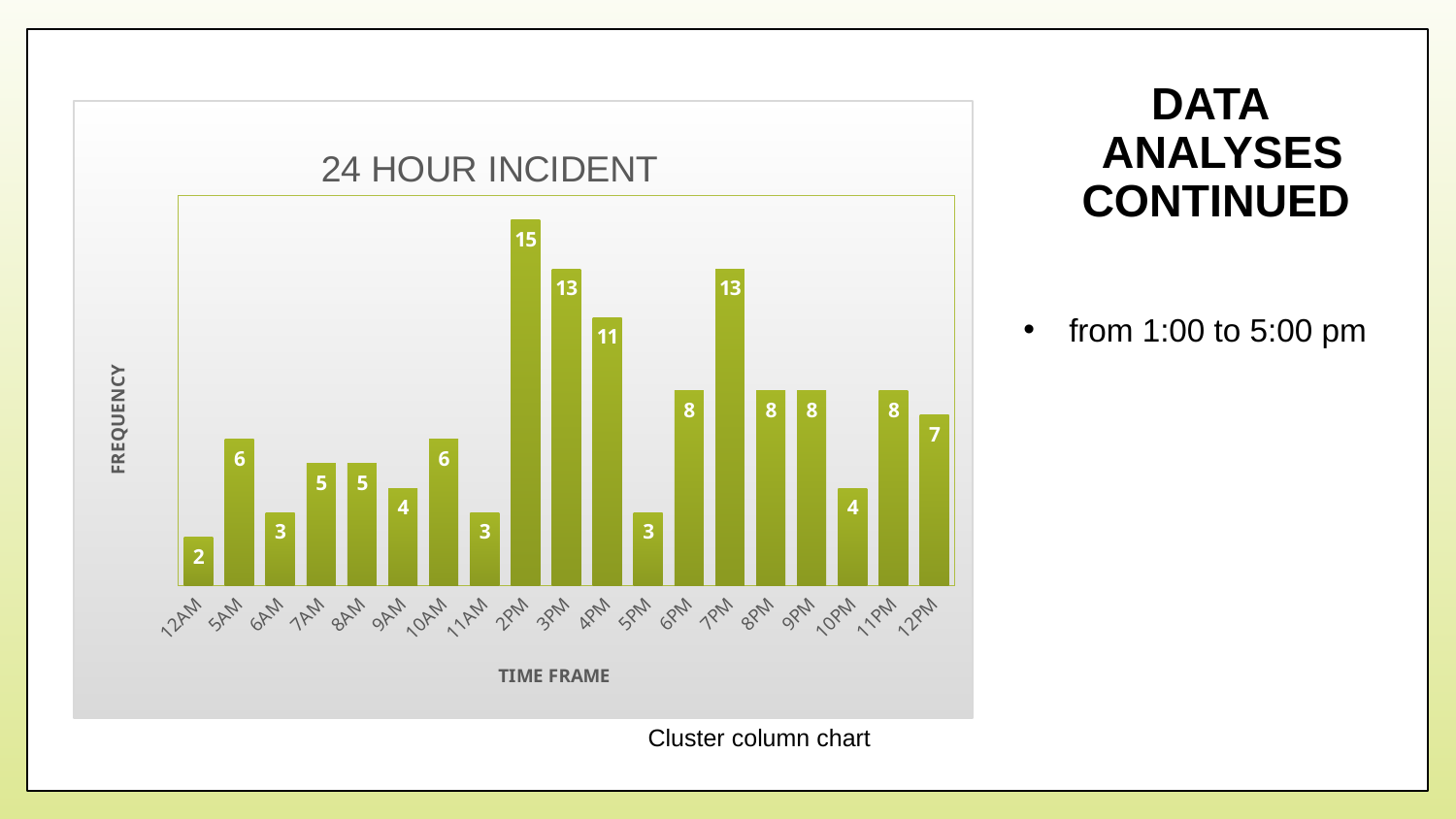
What is the frequency value for 12AM? 2 What is the label of the y axis? FREQUENCY Which time frame has the lowest frequency? 12AM Which has a higher frequency, 5AM or 6AM? 5AM What is the title of the chart? 24 HOUR INCIDENT What is the frequency value for 10PM? 4 What type of chart is shown on the slide? Bar chart What is the frequency value for 2PM? 15 What is the difference between the frequency at 2PM and the frequency at 4PM? 4 What is the frequency value for 7PM? 13 How many time frame categories are shown on the x axis? 19 Which time frame has the highest frequency? 2PM